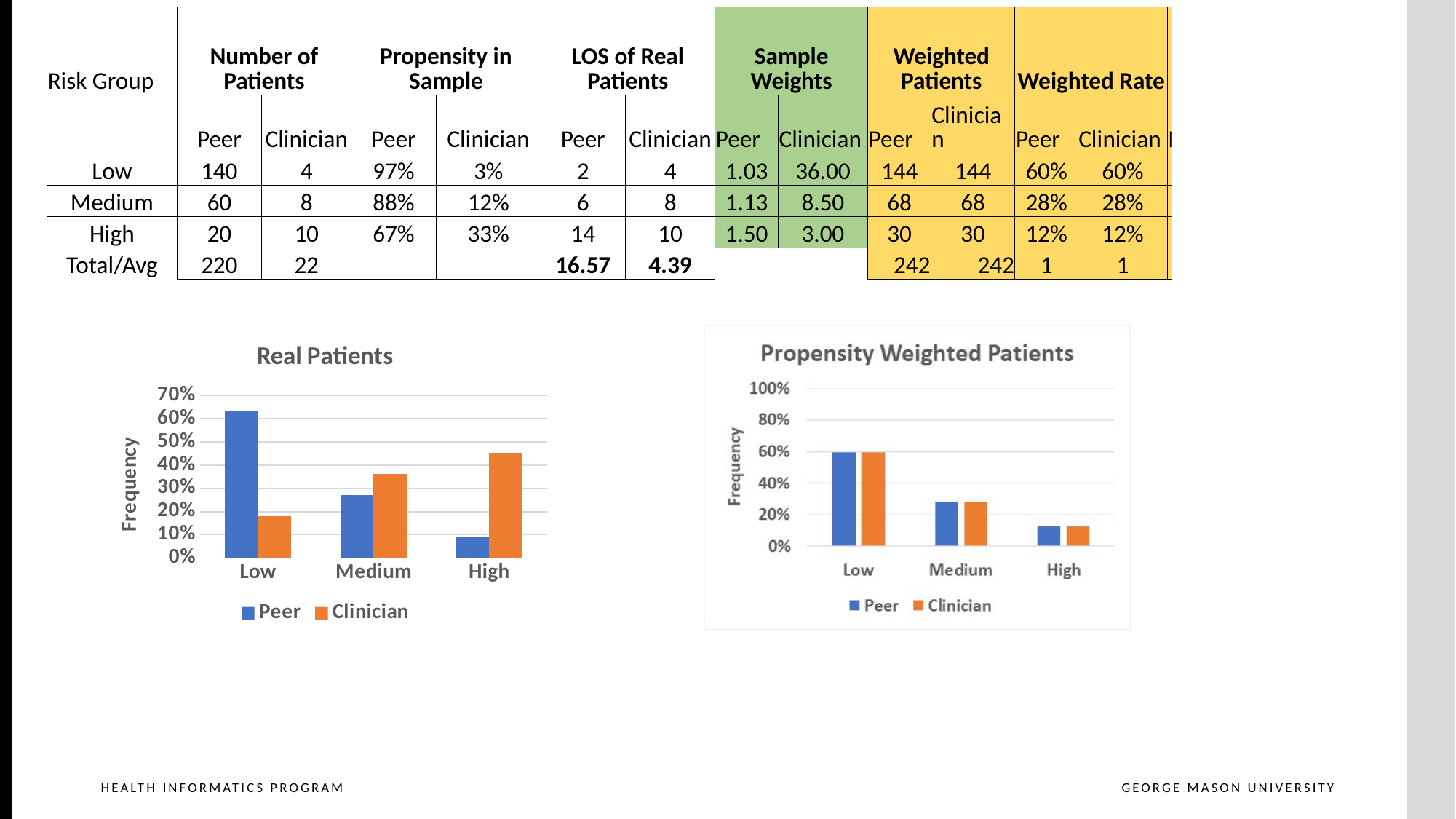
What is the y-axis label of the "Propensity Weighted Patients" chart? Frequency How many series does the legend of the "Real Patients" chart list? 2 In the "Propensity Weighted Patients" chart, do the values fall or rise from Low to High? fall In the "Real Patients" chart, which category has the highest Clinician value? High In the "Real Patients" chart, is the Clinician value for Low greater or less than 20%? less How many risk group categories are shown on the x axis of the "Propensity Weighted Patients" chart? 3 What kind of chart is the "Real Patients" chart? bar chart In the "Real Patients" chart, which category has the highest Peer value? Low In the "Real Patients" chart, is the Peer value for Low greater or less than 60%? greater In the "Real Patients" chart, which is larger for Medium, the Peer value or the Clinician value? Clinician In the "Real Patients" chart, is the Clinician value for High greater or less than 40%? greater In the "Real Patients" chart, which category has the lowest Peer value? High